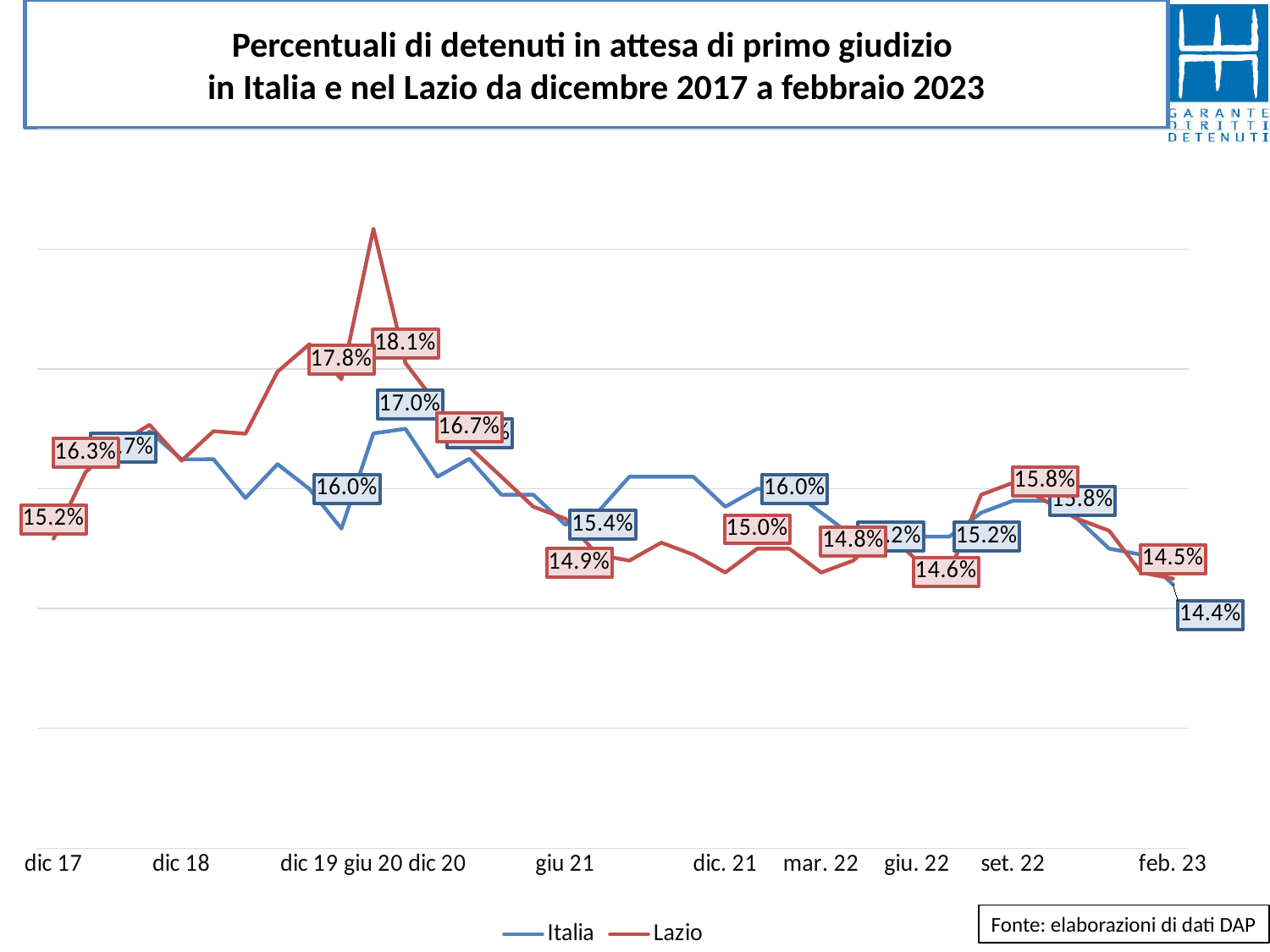
In feb. 23, which series has the larger value, Italia or Lazio? Lazio What is the value for Lazio in dic 17? 15.2% Does the Lazio line rise or fall from set. 22 to feb. 23? Fall What is the value for Lazio in feb. 23? 14.5% What is the lowest labelled value for Italia? 14.4% What is the value for Italia in feb. 23? 14.4% What kind of chart is shown on the slide? Line chart What is the highest labelled value for Lazio? 18.1% How many series does the legend list? 2 Which two series are listed in the legend? Italia and Lazio